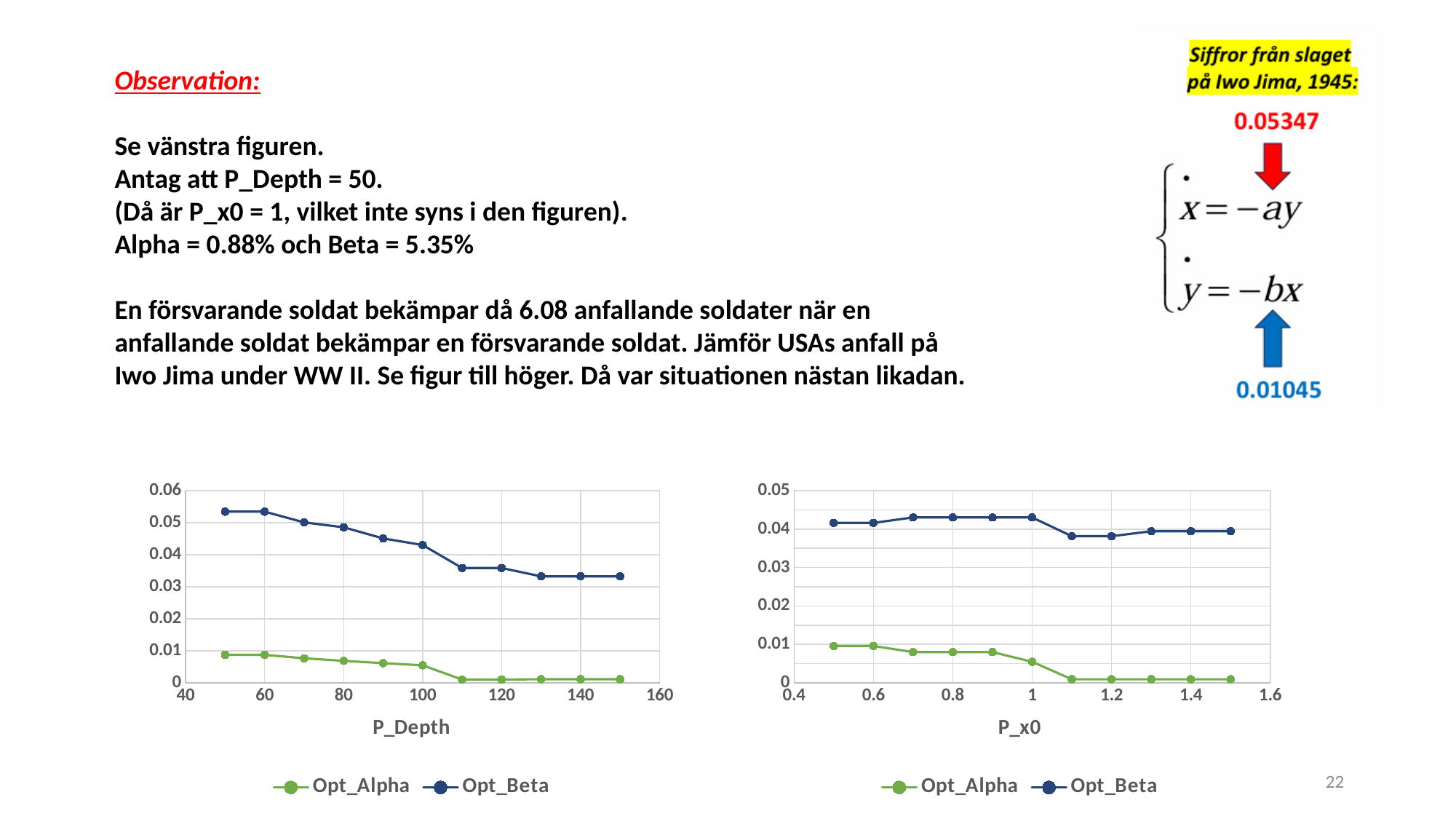
In the left chart (P_Depth), is the Opt_Beta value at P_Depth = 150 greater or less than 0.04? less In the right chart (P_x0), which series has the larger value at P_x0 = 1, Opt_Alpha or Opt_Beta? Opt_Beta In the right chart (P_x0), is the Opt_Beta value at P_x0 = 1.1 greater or less than 0.04? less What is the x-axis label of the right chart? P_x0 In the left chart (P_Depth), does Opt_Beta rise or fall as P_Depth increases? fall How many data points does the Opt_Beta series have in the left chart (P_Depth)? 11 What kind of chart is the left chart (P_Depth)? line chart How many series does the legend of the right chart (P_x0) list? 2 In the left chart (P_Depth), is the Opt_Beta value at P_Depth = 50 greater or less than 0.05? greater How many data points does the Opt_Alpha series have in the right chart (P_x0)? 11 In the left chart (P_Depth), what are the names of the two series in the legend? Opt_Alpha and Opt_Beta